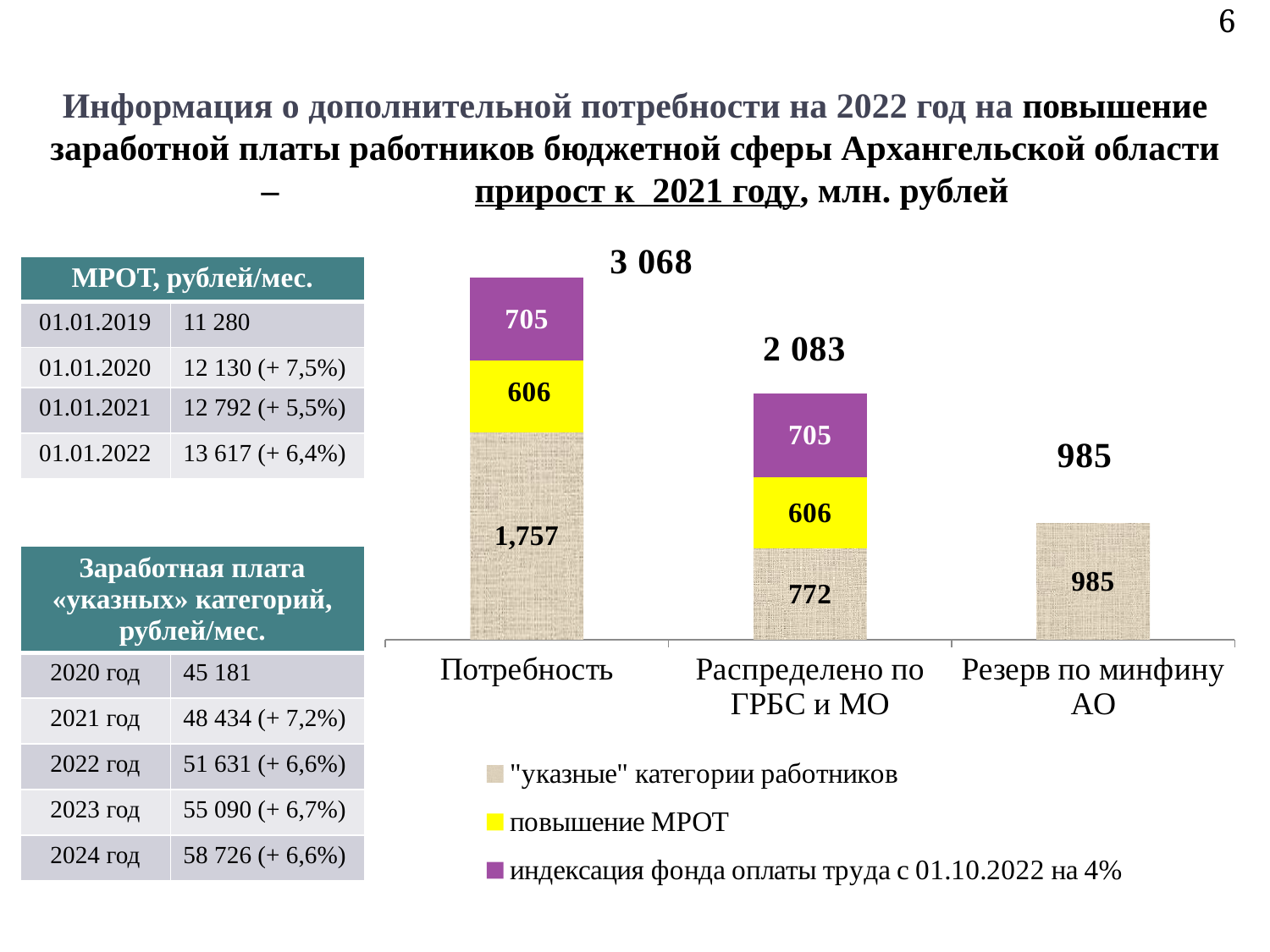
What kind of chart is shown on the slide? Stacked bar chart What is the value of the "указные" категории работников segment for Потребность? 1,757 What is the total shown above the Распределено по ГРБС и МО bar? 2 083 What is the value of the индексация фонда оплаты труда с 01.10.2022 на 4% segment for Распределено по ГРБС и МО? 705 Which category has the lowest total? Резерв по минфину АО What is the total shown above the Резерв по минфину АО bar? 985 Which category has the highest total? Потребность What is the value of the "указные" категории работников segment for Распределено по ГРБС и МО? 772 What is the value of the повышение МРОТ segment for Потребность? 606 What is the difference between the totals for Потребность and Распределено по ГРБС и МО? 985 What is the total shown above the Потребность bar? 3 068 How many series does the legend list? 3